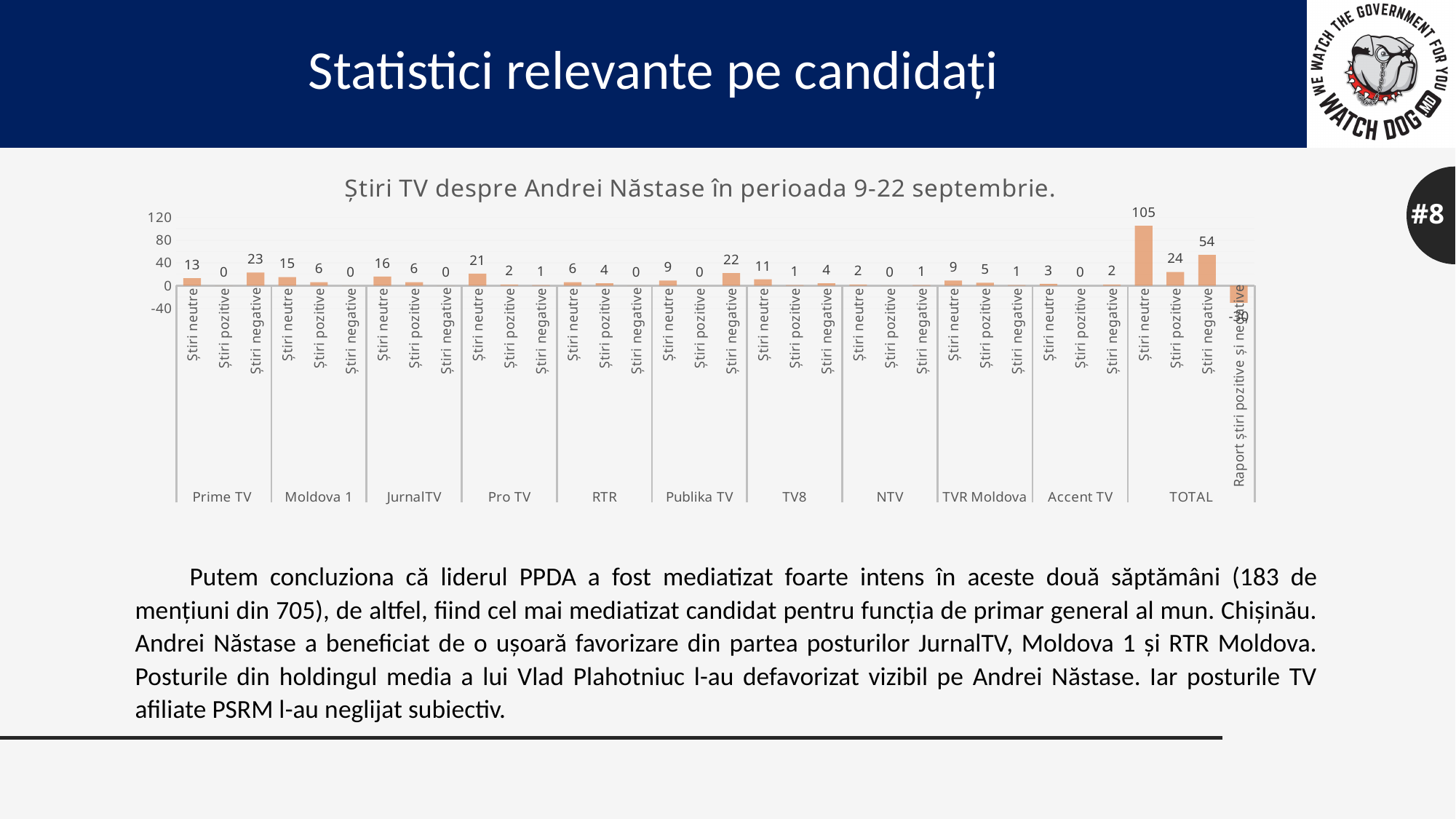
How many TV stations are shown on the x axis, including the TOTAL group? 11 Which is larger: Știri neutre at Pro TV or Știri neutre at JurnalTV? Știri neutre at Pro TV What is the difference between Știri neutre and Știri negative in the TOTAL group? 51 What is the value for Știri neutre at Prime TV? 13 What is the value for Știri neutre in the TOTAL group? 105 What is the value for Știri negative at Publika TV? 22 What is the title of the chart? Știri TV despre Andrei Năstase în perioada 9-22 septembrie. What is the difference between Știri neutre and Știri pozitive at TV8? 10 Which TV station has the highest number of Știri negative (excluding TOTAL)? Prime TV What kind of chart is shown on the slide? Bar chart What is the value for Știri pozitive at Moldova 1? 6 Is the value for Știri neutre in the TOTAL group greater or less than 80? greater